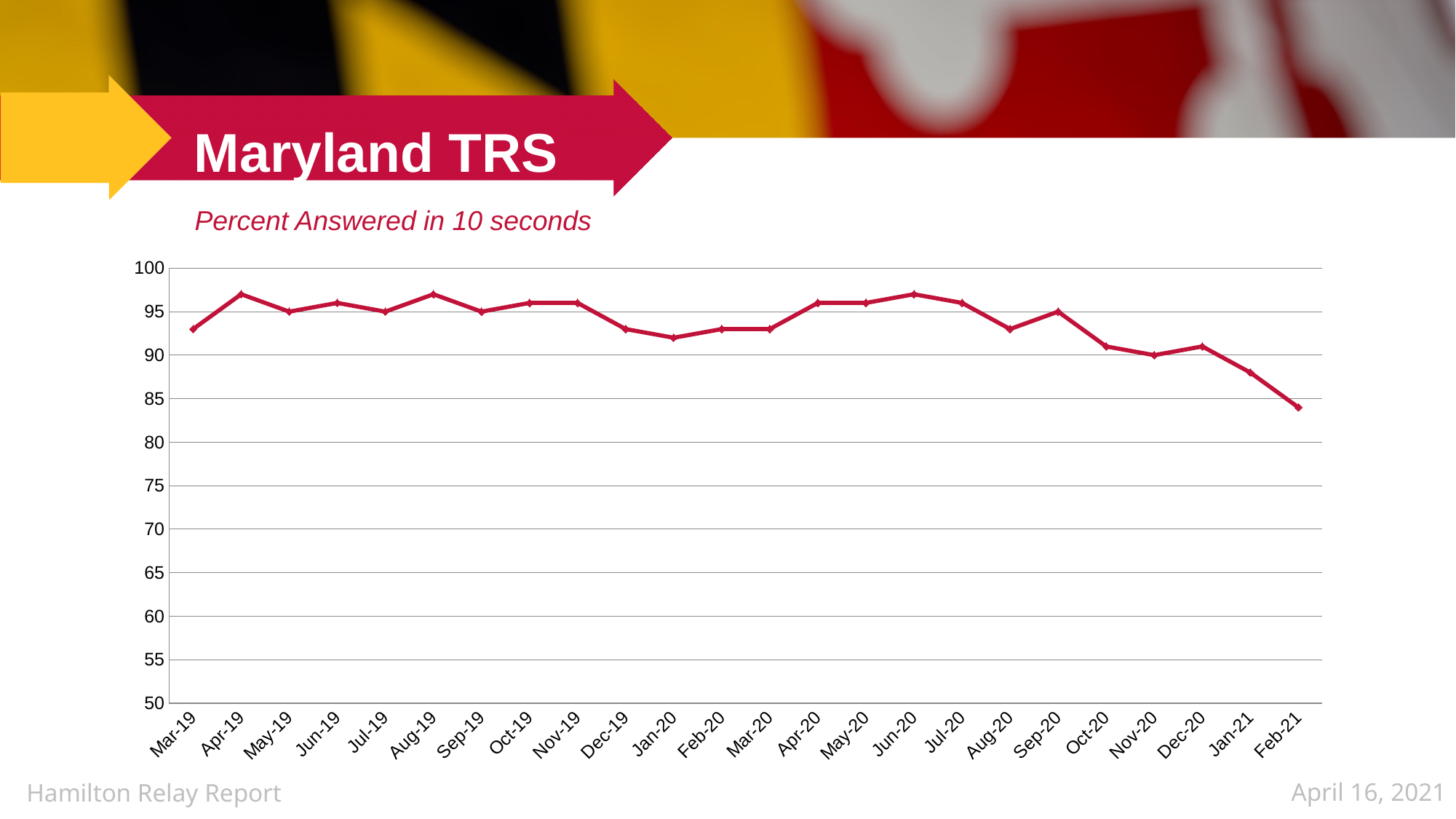
Which month has the lowest percent answered in 10 seconds? Feb-21 Is the value for Feb-21 greater or less than 85? less Is the value for Apr-19 greater or less than 95? greater Which is larger, the value for Dec-20 or the value for Jan-21? Dec-20 What kind of chart is shown on the slide? line chart Do the values generally rise or fall from Sep-20 to Feb-21? fall What is the title of the chart? Percent Answered in 10 seconds Which is larger, the value for Mar-19 or the value for Feb-21? Mar-19 Is the value for Jan-20 greater or less than 95? less How many monthly data points are plotted on the chart? 24